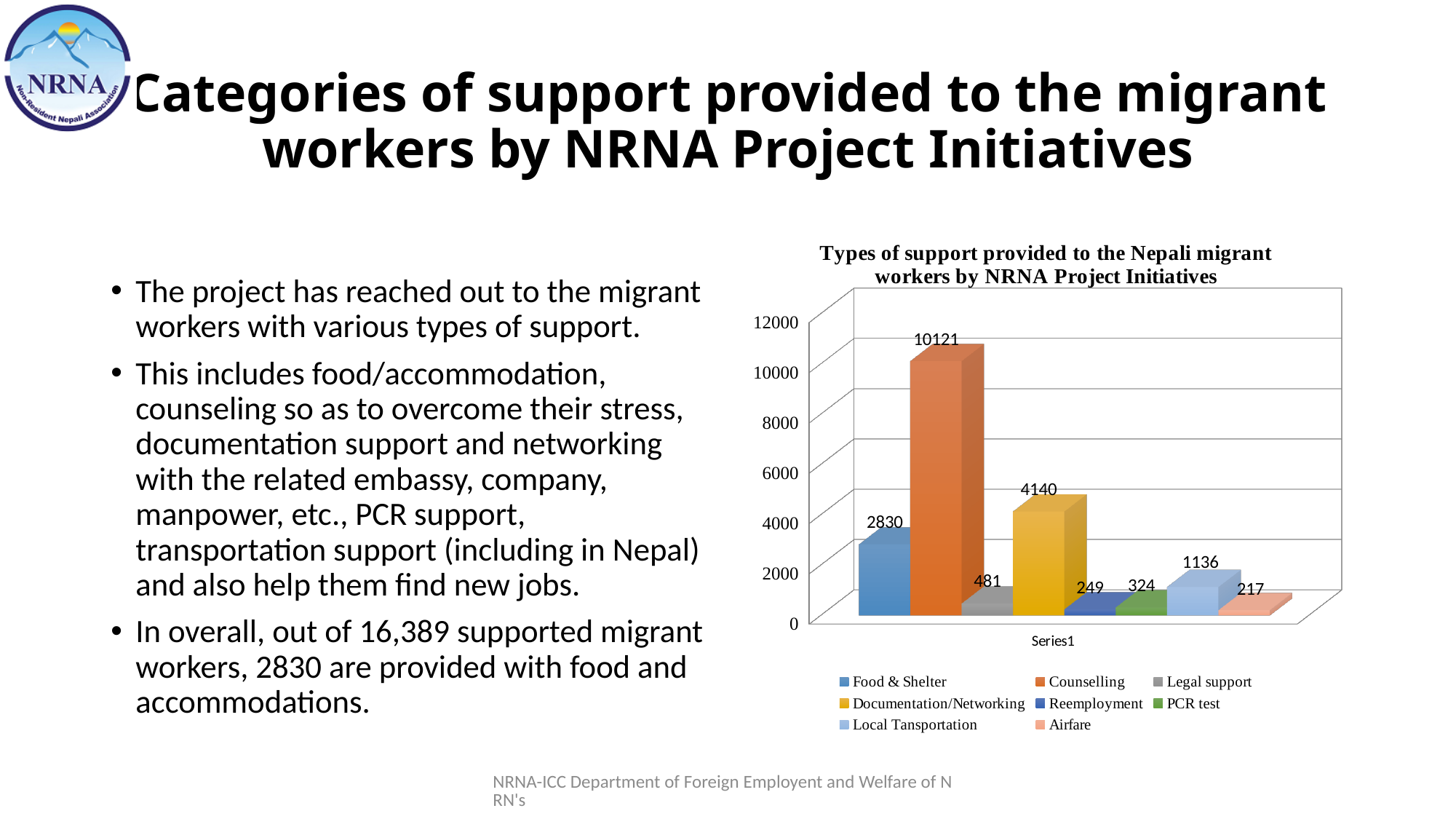
Which is larger, the value for Food & Shelter or the value for Legal support? Food & Shelter What is the value for Airfare? 217 How many categories of support does the legend list? 8 What is the value for Counselling? 10121 Is the value for Food & Shelter greater or less than 2000? greater What kind of chart is shown on the slide? bar chart Which category of support has the lowest value? Airfare What is the title of the chart? Types of support provided to the Nepali migrant workers by NRNA Project Initiatives Which category of support has the highest value? Counselling What is the difference between the values for Counselling and Documentation/Networking? 5981 What is the value for Local Tansportation? 1136 What is the value for Documentation/Networking? 4140